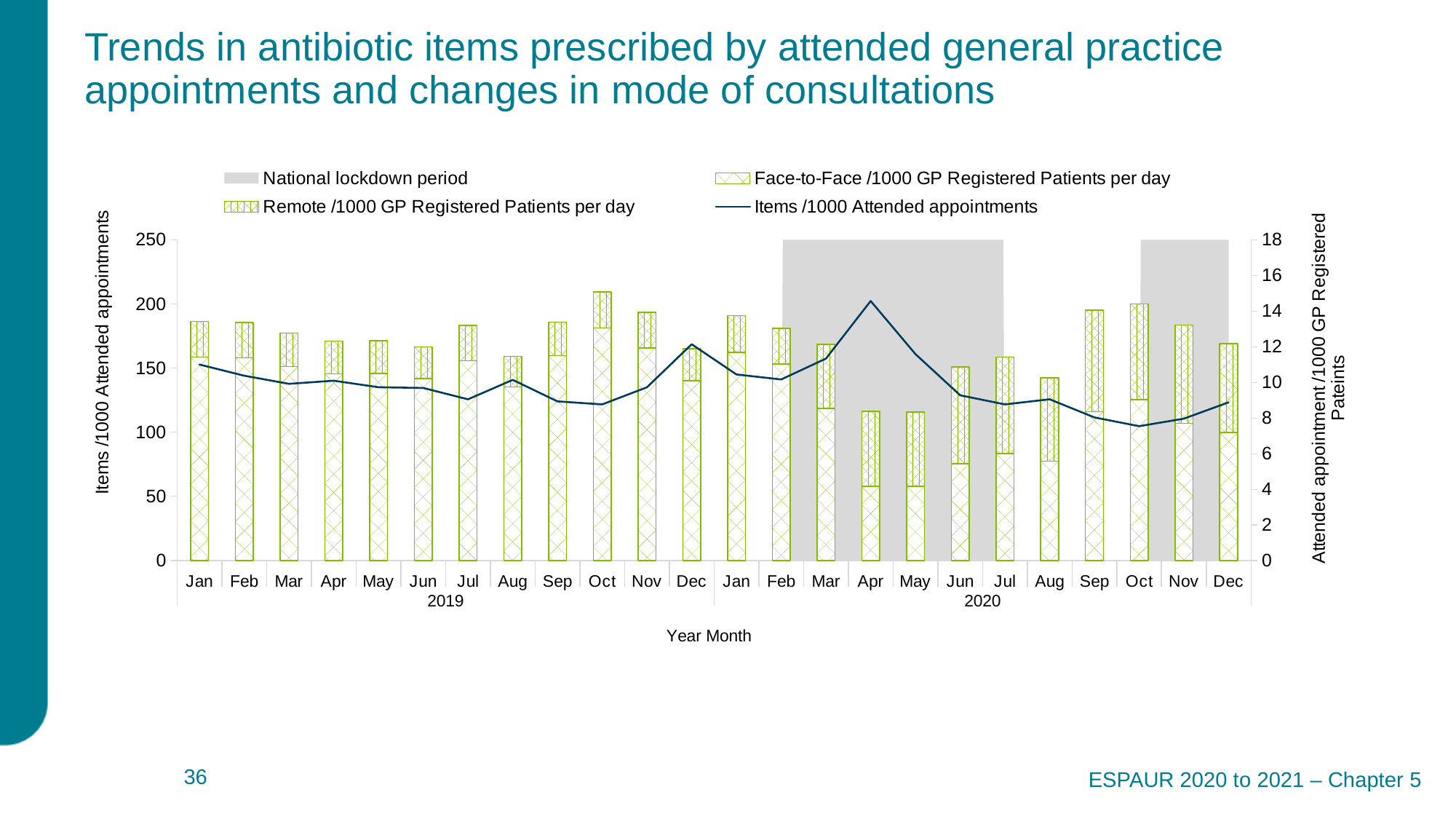
Is the value of the Items /1000 Attended appointments line for Oct 2020 greater or less than 150? less Is the total height of the stacked bar for Apr 2020 greater or less than 10 on the right axis? less How many months are plotted along the x axis? 24 What kind of chart is shown on the slide? A combination chart with stacked bars and a line In which month does the Items /1000 Attended appointments line reach its lowest value? Oct 2020 Is the value of the Items /1000 Attended appointments line for Apr 2020 greater or less than 150? greater Which month has the tallest stacked bar (Face-to-Face plus Remote)? Oct 2019 What does the grey shaded area on the chart represent? National lockdown period Which is higher on the Items /1000 Attended appointments line, Apr 2020 or Oct 2020? Apr 2020 In which month does the Items /1000 Attended appointments line reach its highest value? Apr 2020 How many series does the legend list? 4 Does the Items /1000 Attended appointments line rise or fall from Jan 2020 to Apr 2020? rise